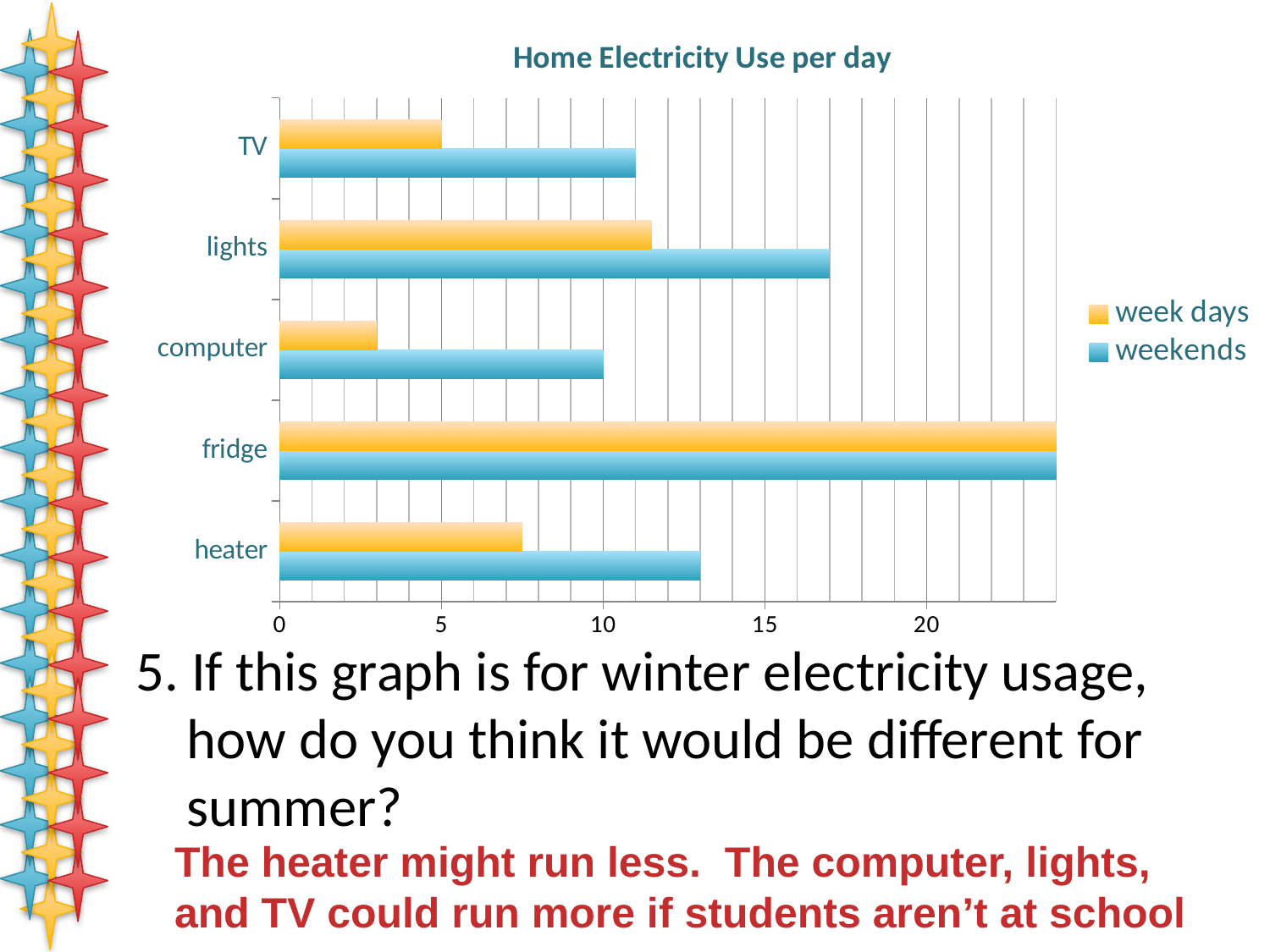
What is the title of the chart? Home Electricity Use per day Is the weekends value for heater greater or less than 10? greater Which is larger, the weekends value for lights or the weekends value for TV? lights How many categories are shown on the chart? 5 Is the week days value for fridge greater or less than 20? greater Which category has the lowest week days value? computer Is the week days value for computer greater or less than 5? less Which category has the highest weekends value? fridge Which colour represents the week days series in the legend? yellow How many series does the legend list? 2 What kind of chart is shown on the slide? bar chart